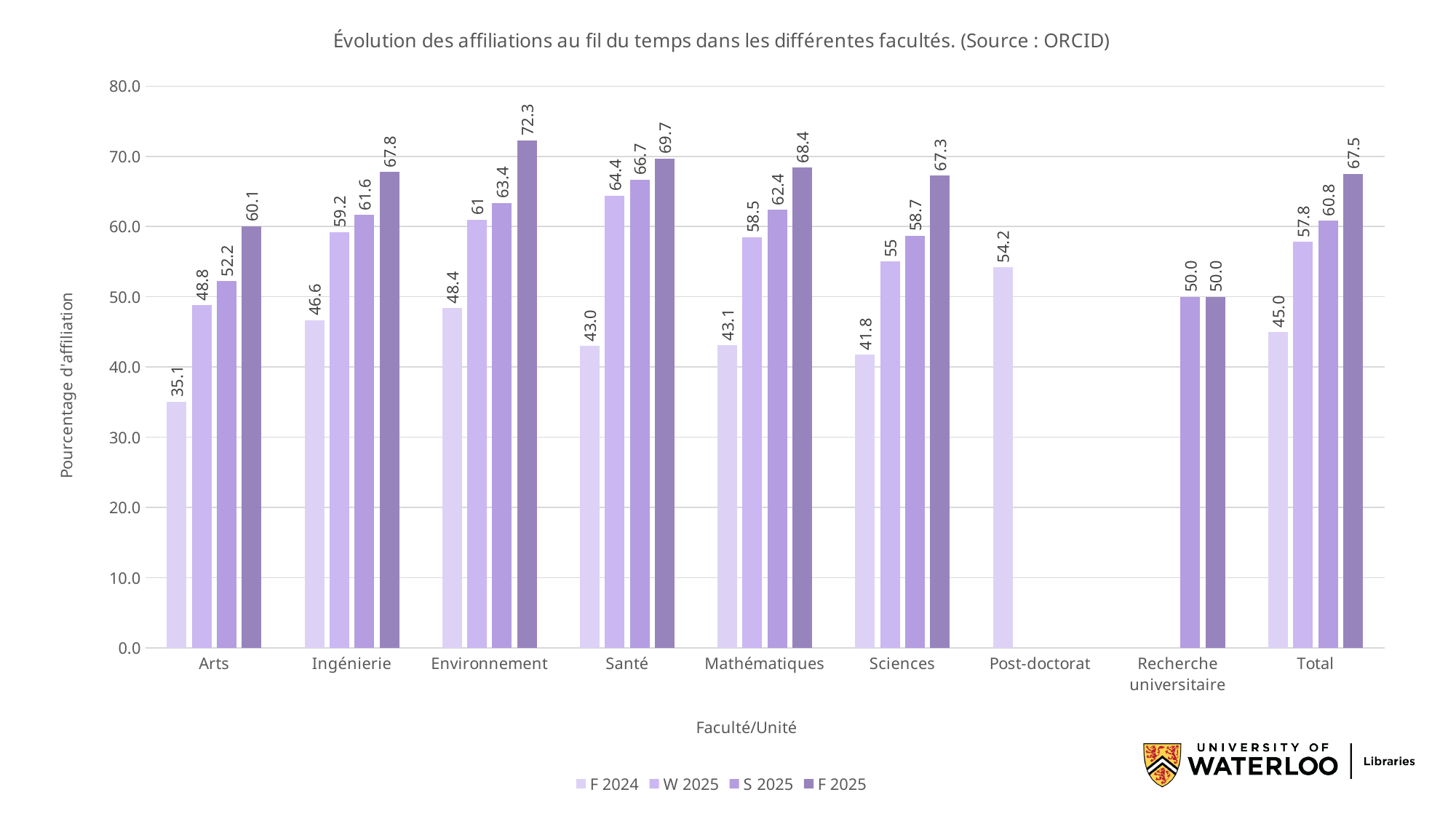
What is the value shown for Post-doctorat? 54.2 Which category has the highest F 2025 value? Environnement Which category has the lowest F 2024 value? Arts How many series does the legend list? 4 How many categories are shown on the x axis? 9 Which has the larger W 2025 value, Santé or Ingénierie? Santé What is the difference between the F 2025 and F 2024 values for Total? 22.5 What is the title of the y axis? Pourcentage d'affiliation What is the F 2024 value for Arts? 35.1 What kind of chart is shown on the slide? Bar chart What is the F 2025 value for Environnement? 72.3 Do the values for Arts rise or fall from F 2024 to F 2025? Rise